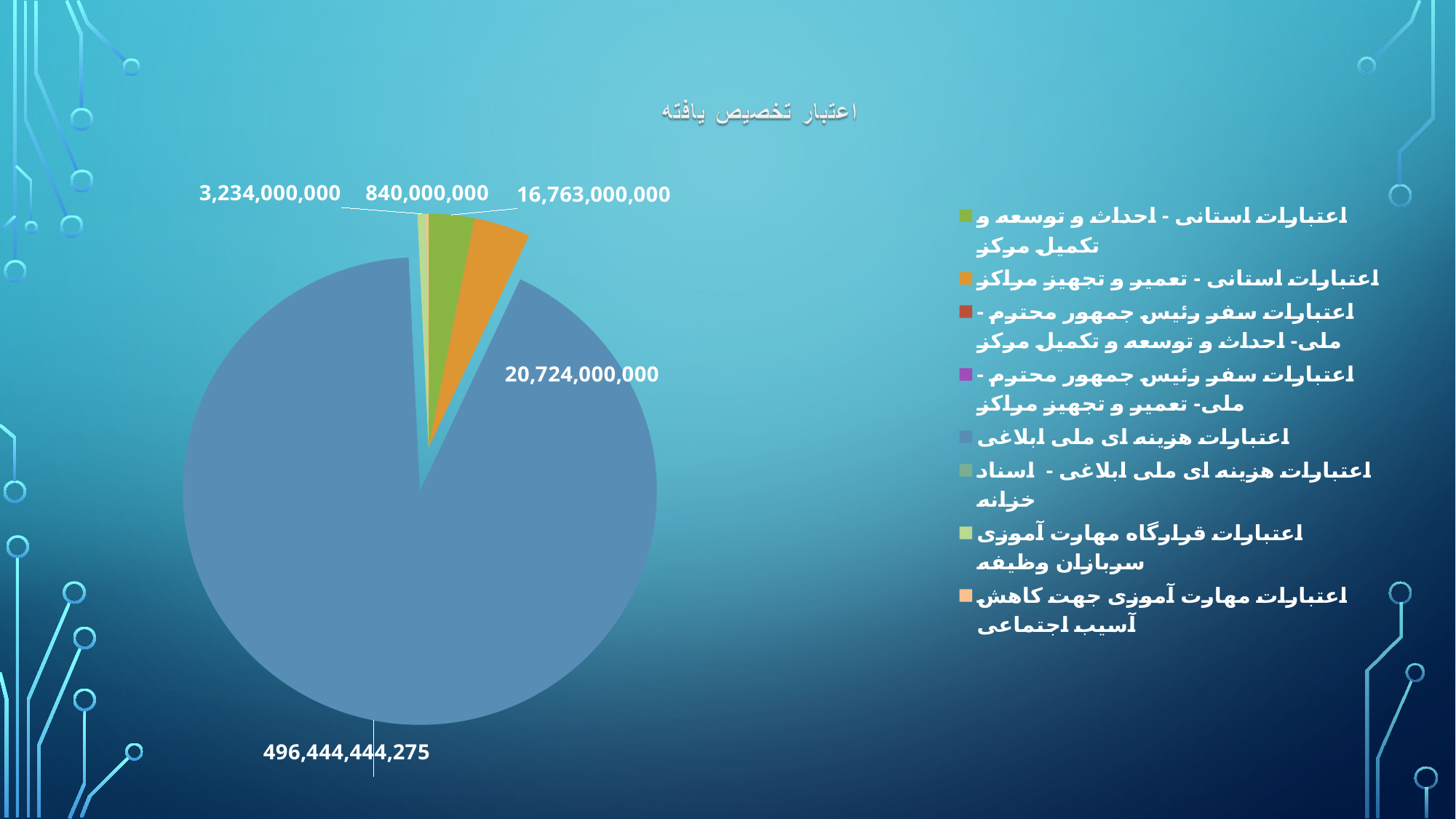
What is the value shown for اعتبارات استانی - تعمیر و تجهیز مراکز? 20,724,000,000 How many entries does the chart's legend list? 8 What kind of chart is shown on the slide? pie chart What is the smallest value printed as a data label on the chart? 840,000,000 What is the value shown for اعتبارات هزینه ای ملی ابلاغی? 496,444,444,275 What is the title of the chart? اعتبار تخصیص یافته What is the difference between the values 20,724,000,000 and 16,763,000,000 shown on the chart? 3,961,000,000 What is the difference between the data labels 3,234,000,000 and 840,000,000? 2,394,000,000 Which category has the largest slice of the pie? اعتبارات هزینه ای ملی ابلاغی Which is larger: the slice for اعتبارات استانی - تعمیر و تجهیز مراکز or the slice for اعتبارات استانی - احداث و توسعه و تکمیل مرکز? اعتبارات استانی - تعمیر و تجهیز مراکز What is the value shown for اعتبارات استانی - احداث و توسعه و تکمیل مرکز? 16,763,000,000 How many data labels are printed on the pie chart? 5